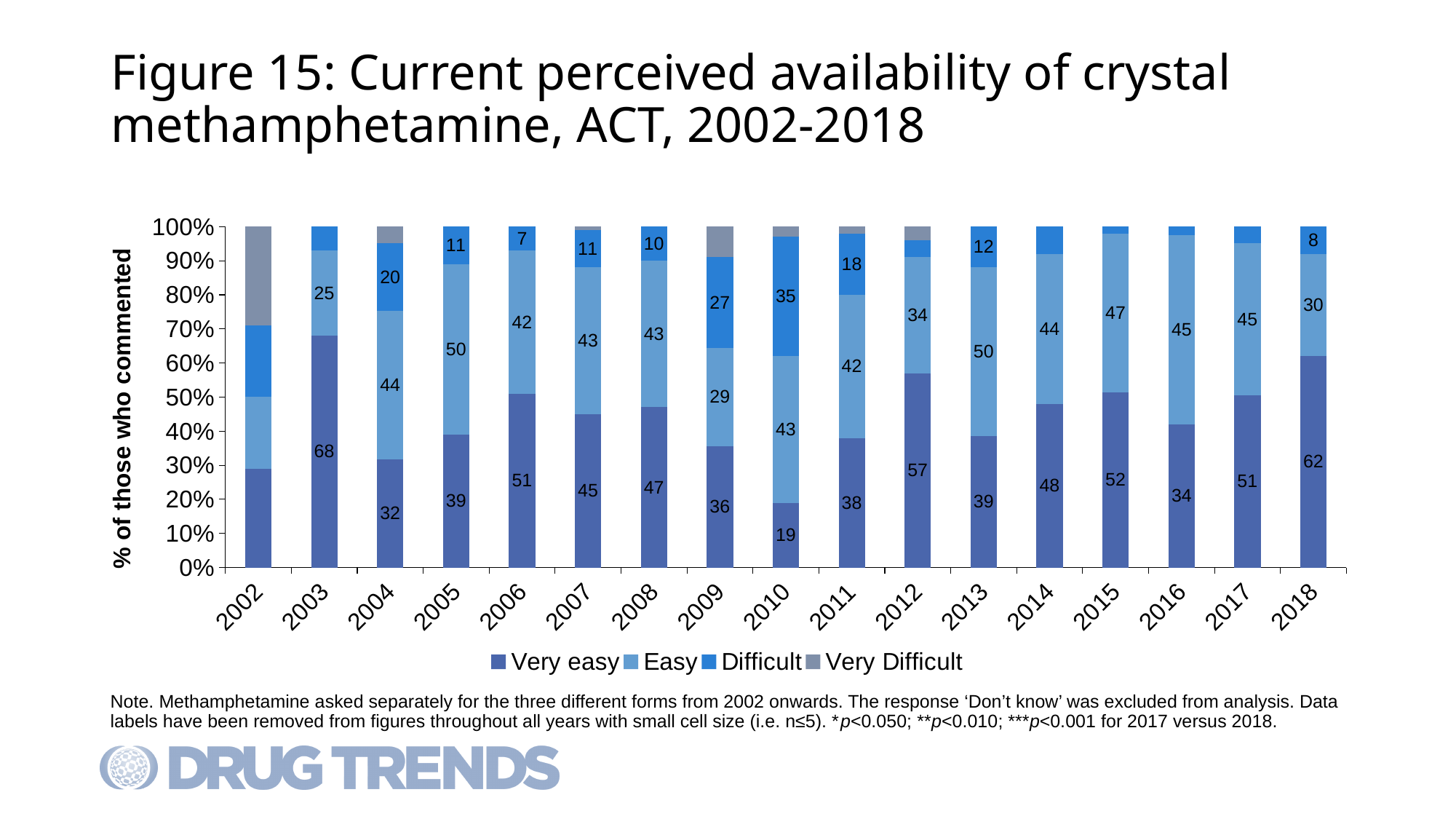
In which year is the 'Very easy' value highest? 2003 What is the 'Difficult' value for 2011? 18 What is the 'Easy' value for 2005? 50 Is the 'Very easy' value for 2002 greater or less than 40%? less Which year has the larger 'Easy' value, 2004 or 2013? 2013 How many series does the legend list? 4 What is the difference between the 'Very easy' values for 2018 and 2017? 11 How many years are shown along the x axis? 17 In which year is the 'Very easy' value lowest? 2010 What is the 'Very easy' value for 2018? 62 What is the 'Difficult' value for 2010? 35 What kind of chart is shown on the slide? Stacked bar chart